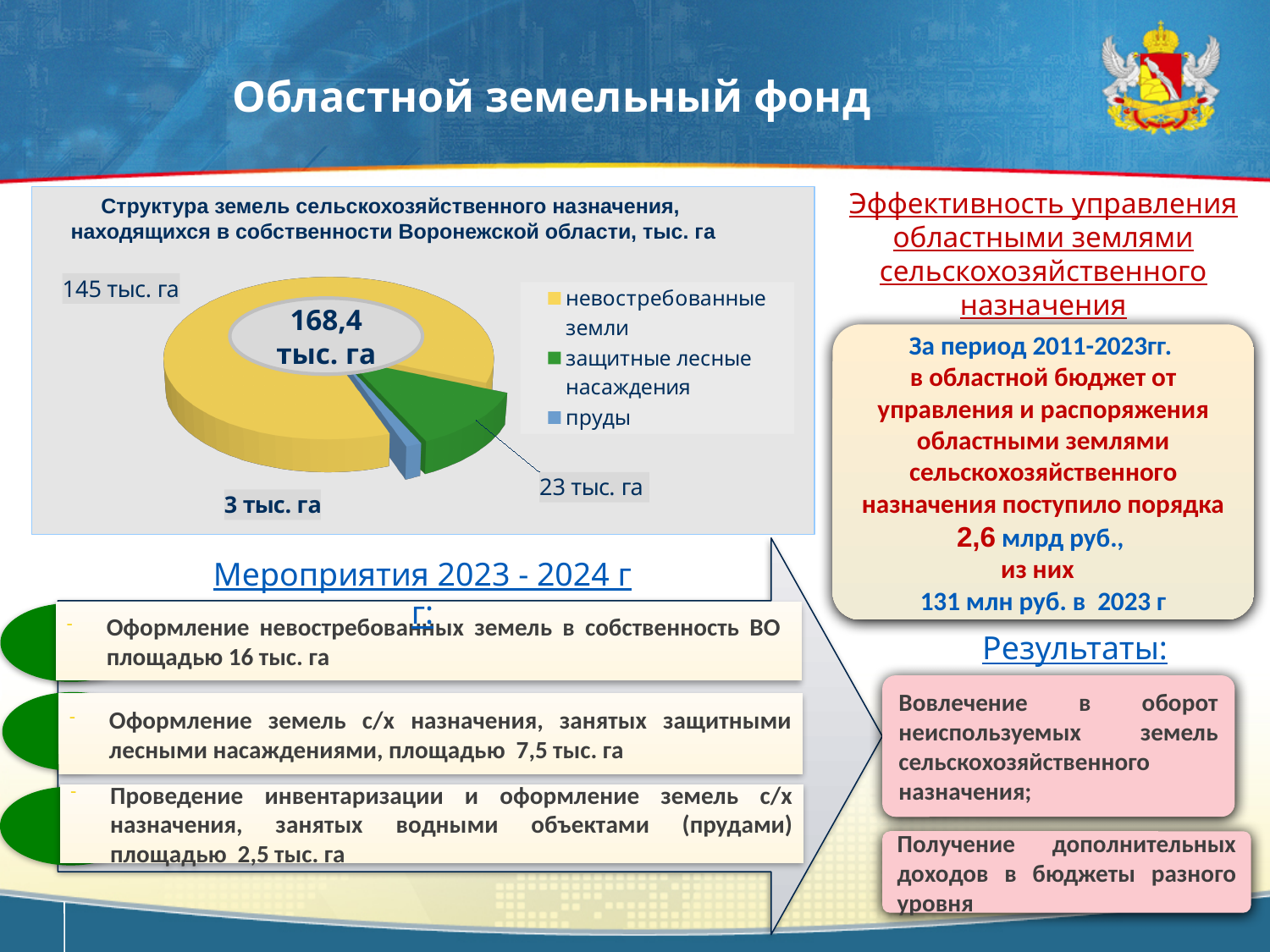
Which category has the largest slice in the pie chart? невостребованные земли What is the value for невостребованные земли in the pie chart? 145 тыс. га Which category has the smallest slice in the pie chart? пруды What is the value for защитные лесные насаждения in the pie chart? 23 тыс. га What is the value for пруды in the pie chart? 3 тыс. га What is the difference between the values for невостребованные земли and защитные лесные насаждения? 122 тыс. га What kind of chart is shown on the slide? pie chart What total value is printed in the centre of the pie chart? 168,4 тыс. га Which is larger: защитные лесные насаждения or пруды? защитные лесные насаждения How many categories does the pie chart show? 3 How many entries does the legend of the pie chart list? 3 What colour is the slice for защитные лесные насаждения? green